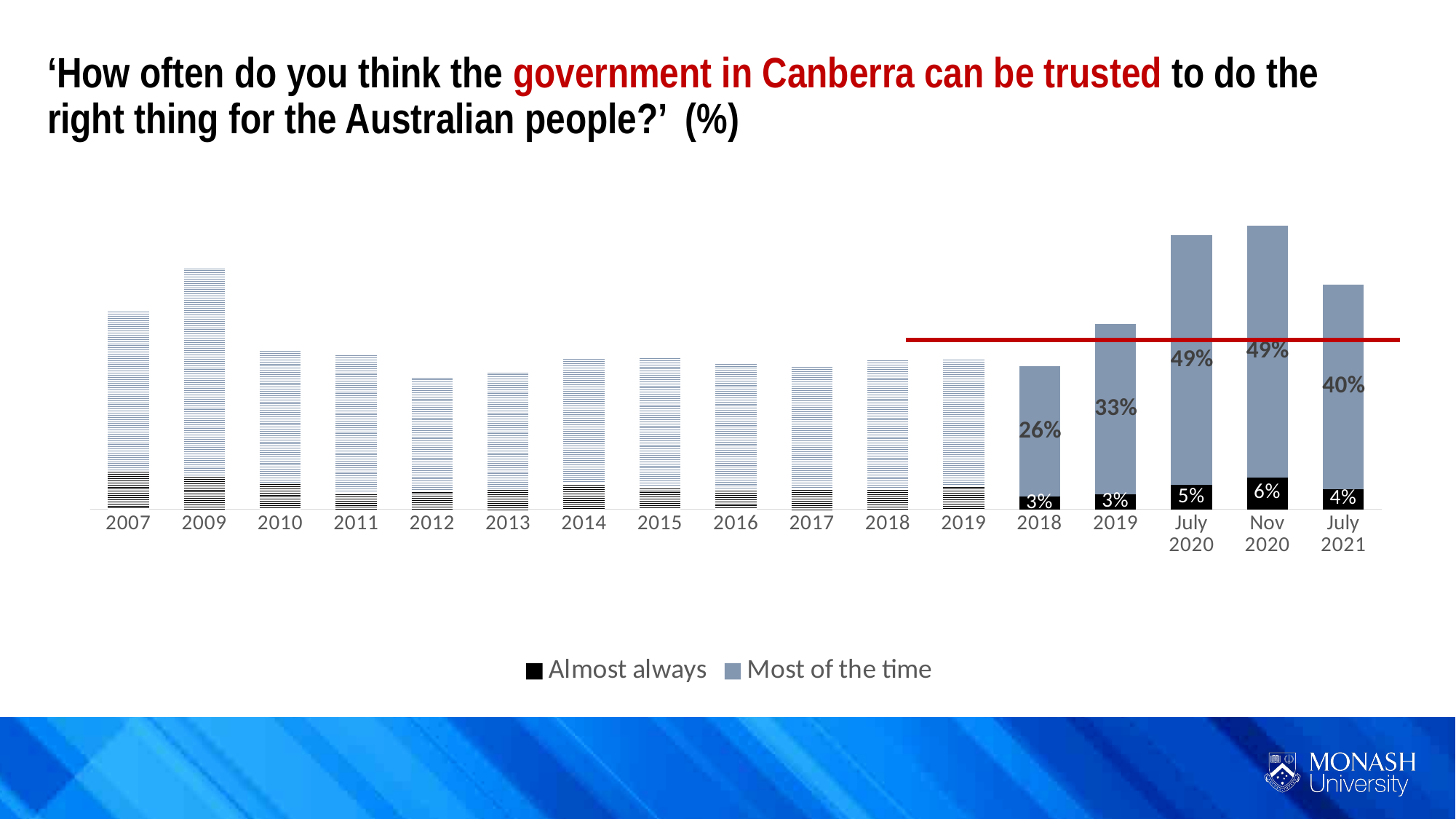
Which is larger: the 'Most of the time' value for the labelled 2018 bar or for the labelled 2019 bar? 2019 What is the difference between the 'Most of the time' values for July 2020 and July 2021? 9% What is the total of the Nov 2020 stacked bar ('Almost always' plus 'Most of the time')? 55% What is the 'Almost always' value for July 2020? 5% What are the two series named in the legend? Almost always; Most of the time What kind of chart is shown on the slide? Stacked bar chart Among the labelled bars, which category has the lowest 'Most of the time' value? 2018 What is the 'Most of the time' value for July 2021? 40% Among the labelled bars, which category has the highest 'Almost always' value? Nov 2020 How many series does the legend list? 2 What is the 'Most of the time' value for the second 2019 bar (the one with data labels)? 33% What is the 'Almost always' value for Nov 2020? 6%